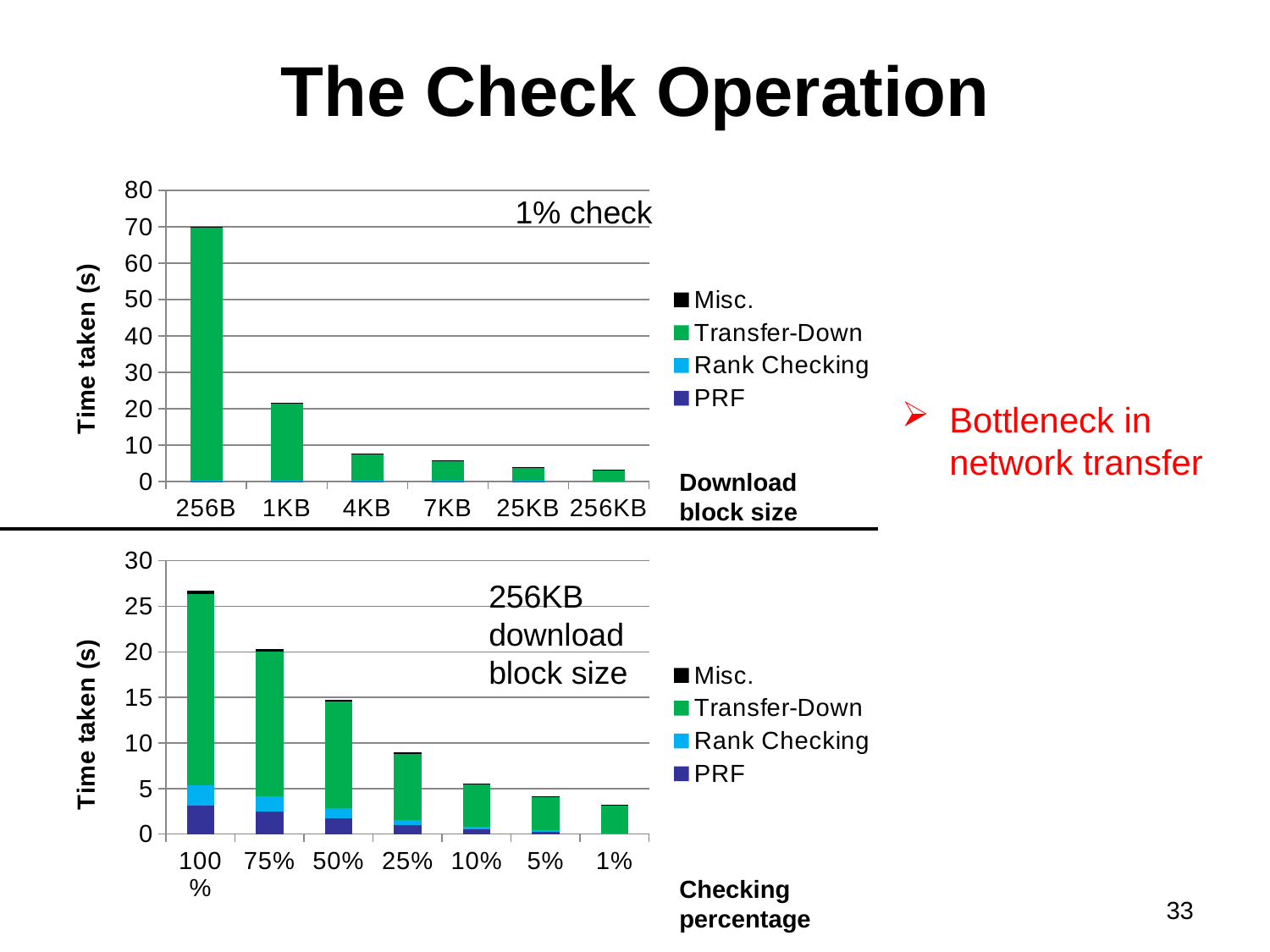
In the top chart (1% check), which download block size has the lowest total time taken? 256KB What kind of chart is the bottom chart (256KB download block size)? Stacked bar chart In the top chart (1% check), is the total time taken for 1KB greater or less than 30? less In the top chart (1% check), how many download block sizes are shown on the x axis? 6 In the top chart (1% check), do the total times rise or fall as the download block size increases along the x axis? fall In the bottom chart (256KB download block size), which checking percentage has the highest total time taken? 100% In the bottom chart (256KB download block size), is the total time taken for 25% greater or less than 10? less In the top chart (1% check), is the total time taken for 256B greater or less than 60? greater In the bottom chart (256KB download block size), which has the larger total time taken, 75% or 50%? 75% In the bottom chart (256KB download block size), how many series does the legend list? 4 In the top chart (1% check), which download block size has the highest total time taken? 256B